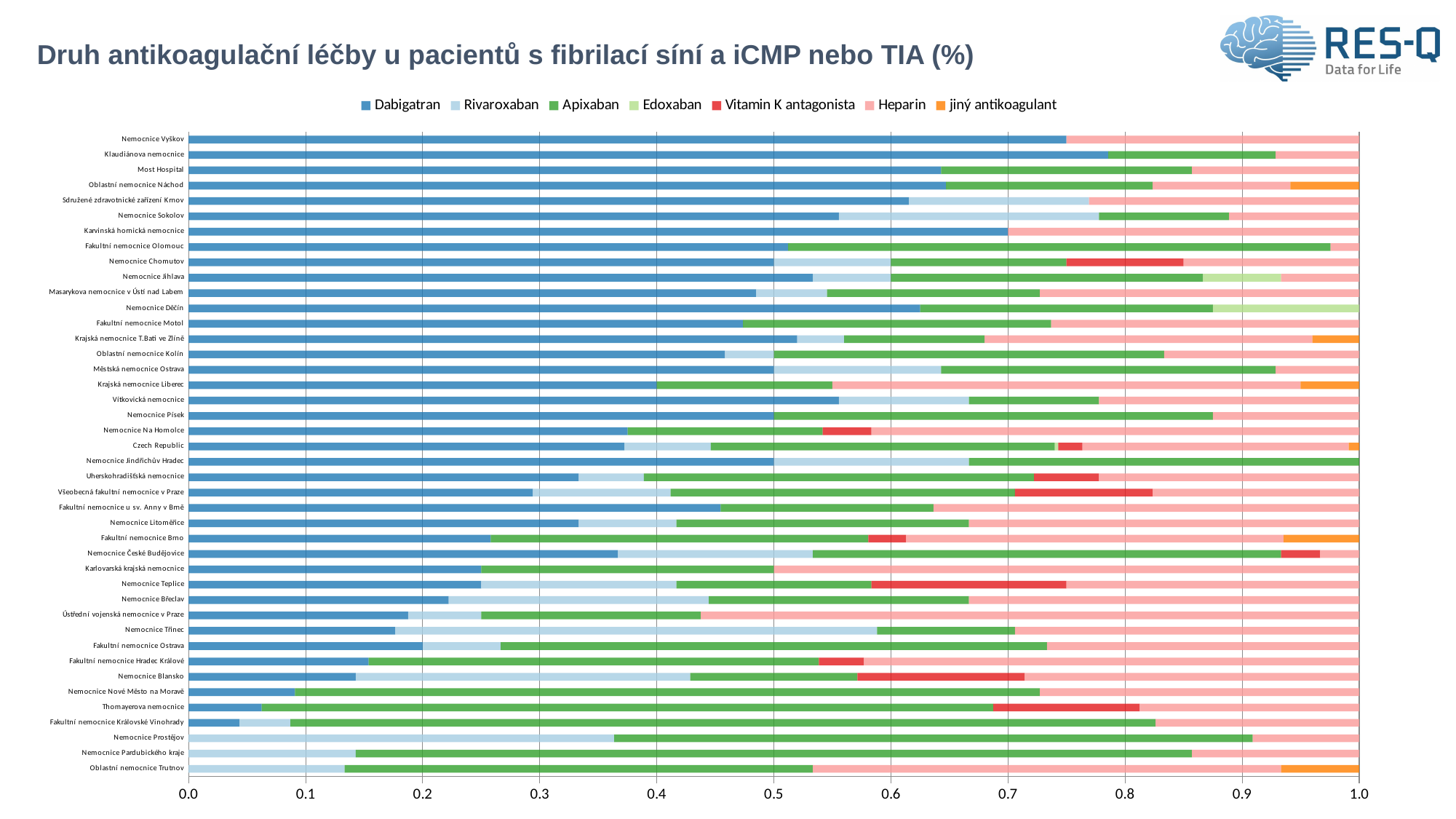
What kind of chart is shown on the slide? stacked bar chart How many hospitals (categories) are plotted on the chart? 42 Is the Dabigatran value for Fakultní nemocnice Královské Vinohrady greater or less than 0.1? less Is the Dabigatran value for Nemocnice Blansko greater or less than 0.1? greater How many series does the legend list? 7 Which has the larger Dabigatran value, Klaudiánova nemocnice or Oblastní nemocnice Trutnov? Klaudiánova nemocnice Is the Dabigatran value for Nemocnice Vyškov greater or less than 0.7? greater Which has the larger Dabigatran value, Nemocnice Vyškov or Nemocnice Blansko? Nemocnice Vyškov What is the title of the chart? Druh antikoagulační léčby u pacientů s fibrilací síní a iCMP nebo TIA (%) Which series in the legend is shown in orange? jiný antikoagulant